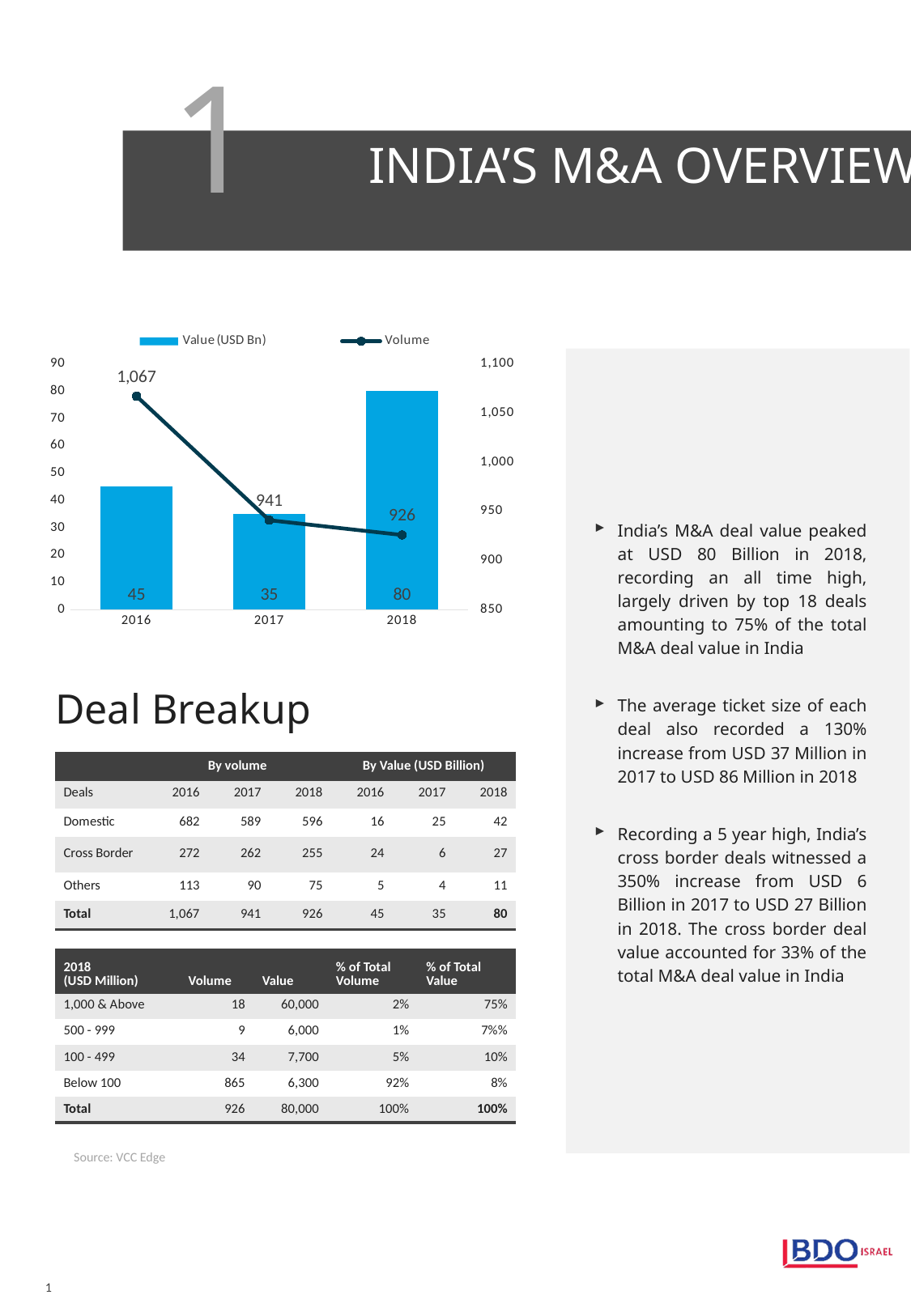
Which series in the chart is drawn as a line? Volume Does the Volume series rise or fall from 2016 to 2018? fall What is the difference between the Value (USD Bn) for 2018 and 2017? 45 Which is larger, the Value (USD Bn) for 2016 or for 2017? 2016 What is the difference in Volume between 2016 and 2017? 126 Which year has the lowest Volume in the chart? 2018 Which year has the highest Value (USD Bn) in the chart? 2018 What is the Volume for 2016 in the chart? 1,067 What is the Value (USD Bn) for 2017 in the chart? 35 What is the Value (USD Bn) for 2018 in the chart? 80 How many years are shown on the x axis of the chart? 3 How many series does the chart legend list? 2